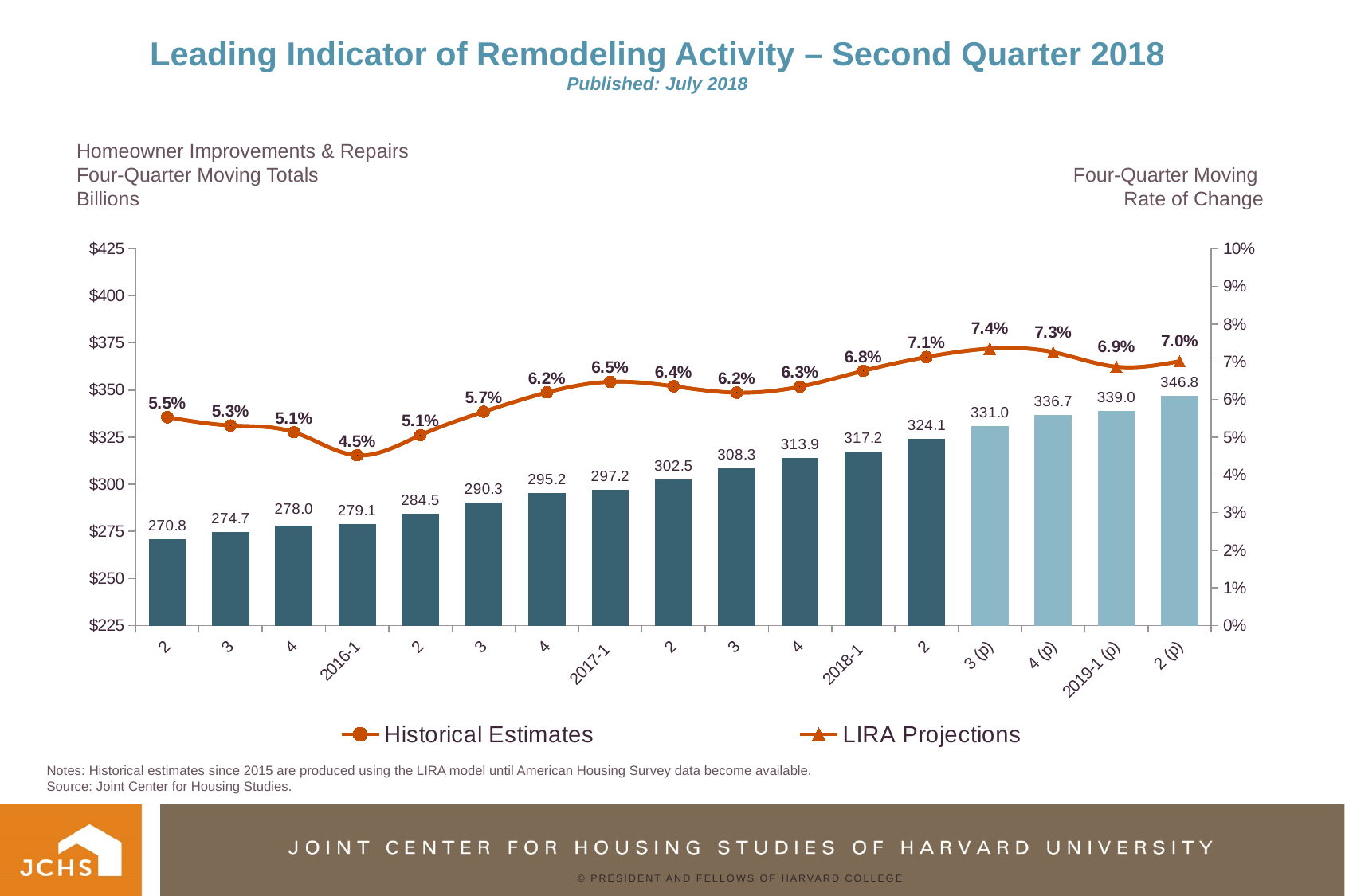
What is the difference between the four-quarter moving total for 2 (p) and the first bar (270.8)? 76.0 What is the four-quarter moving rate of change for 2016-1? 4.5% What is the projected four-quarter moving total for 2 (p)? 346.8 Which has a higher rate of change, 2017-1 or 2018-1? 2018-1 How many series does the legend list? 2 What are the two entries in the chart legend? Historical Estimates and LIRA Projections Do the four-quarter moving totals rise or fall from left to right across the chart? Rise Which period has the lowest four-quarter moving rate of change? 2016-1 Which period has the highest four-quarter moving rate of change? 3 (p) What is the four-quarter moving total (in billions) for 2018-1? 317.2 How many bars are plotted on the chart? 17 What kind of chart is shown on the slide? Combined bar and line chart